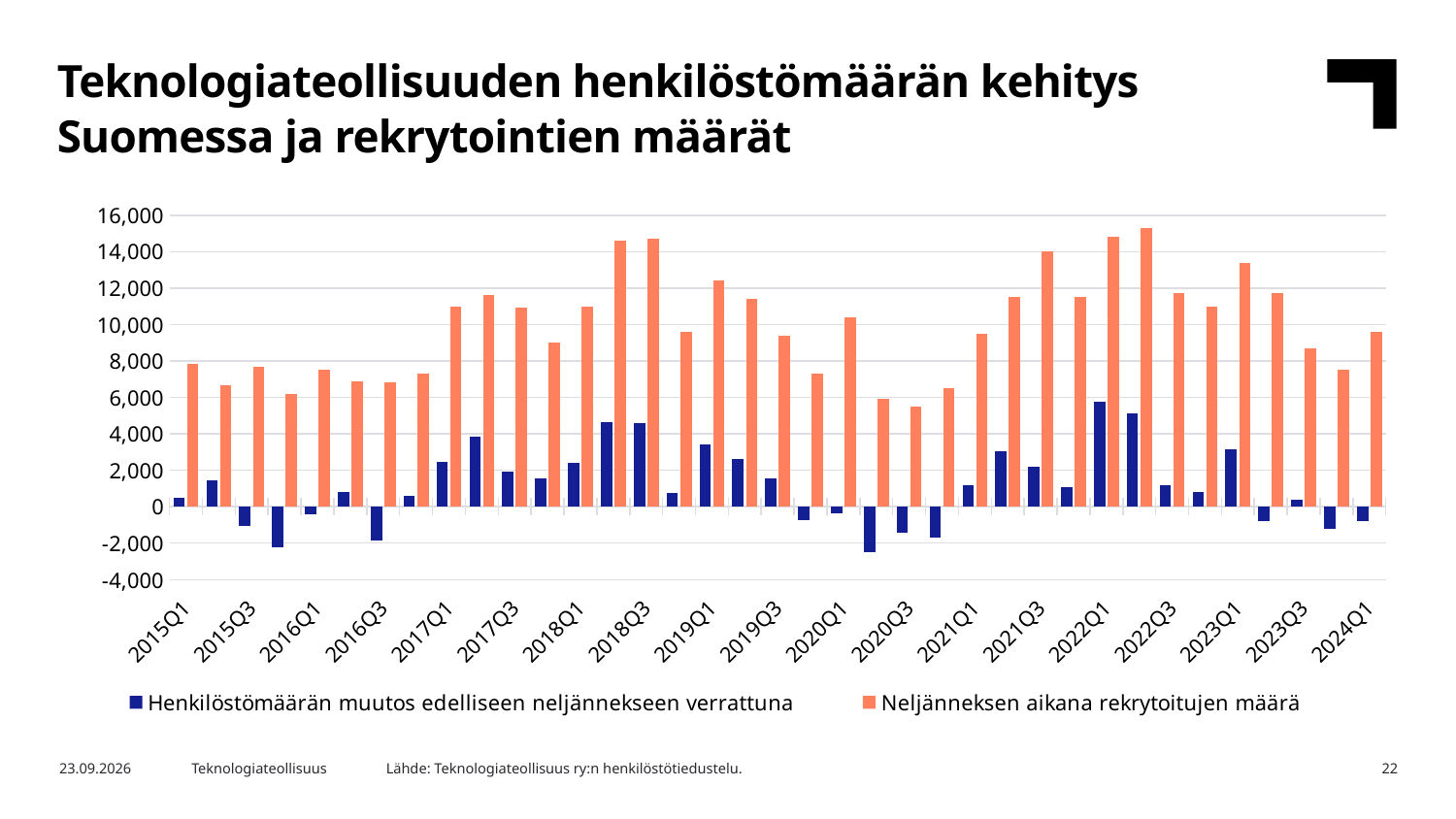
How many quarter labels are shown on the x axis? 19 How many series does the legend list? 2 Is the value of 'Neljänneksen aikana rekrytoitujen määrä' for 2023Q1 greater or less than 12,000? greater Is the value of 'Neljänneksen aikana rekrytoitujen määrä' for 2024Q1 greater or less than 8,000? greater What is the first series named in the legend? Henkilöstömäärän muutos edelliseen neljännekseen verrattuna Is the value of 'Neljänneksen aikana rekrytoitujen määrä' for 2015Q1 greater or less than 6,000? greater Which is larger: 'Henkilöstömäärän muutos edelliseen neljännekseen verrattuna' in 2022Q1 or in 2024Q1? 2022Q1 Which colour represents 'Neljänneksen aikana rekrytoitujen määrä'? orange What kind of chart is shown on the slide? bar chart Which is larger: 'Neljänneksen aikana rekrytoitujen määrä' in 2018Q3 or in 2020Q3? 2018Q3 Does 'Neljänneksen aikana rekrytoitujen määrä' generally rise or fall from 2020Q3 to 2022Q2? rise